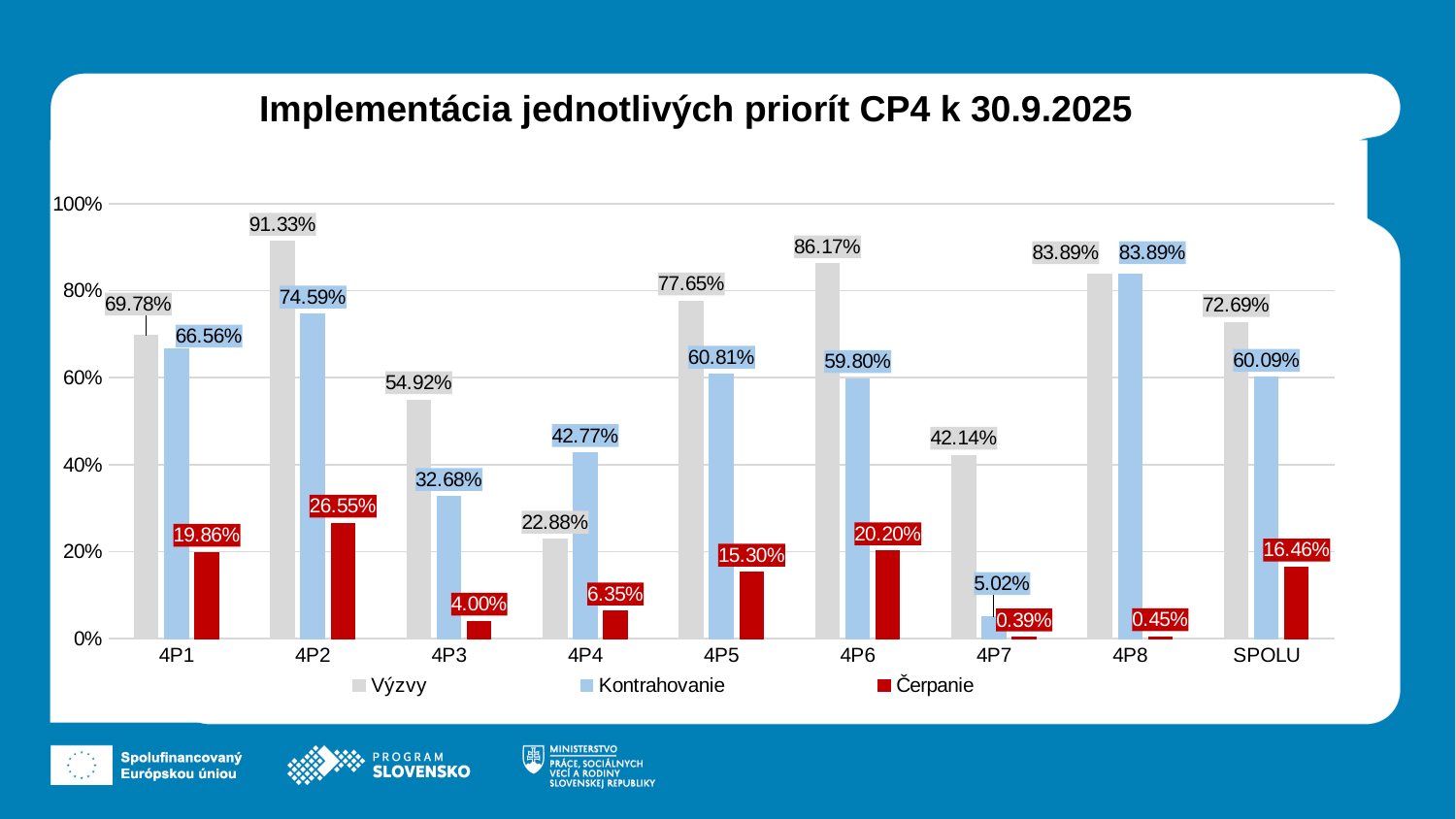
Is the Kontrahovanie value for 4P7 greater or less than 20%? less How many categories are shown on the x axis? 9 What is the Výzvy value for 4P2? 91.33% Which category has the lowest Čerpanie value? 4P7 How many series does the legend list? 3 Which is larger for 4P4: the Výzvy value or the Kontrahovanie value? Kontrahovanie What is the difference between the Výzvy and Kontrahovanie values for 4P2? 16.74% What is the Kontrahovanie value for SPOLU? 60.09% What is the title of the chart? Implementácia jednotlivých priorít CP4 k 30.9.2025 What kind of chart is shown on the slide? bar chart Which category has the highest Výzvy value? 4P2 What is the Čerpanie value for 4P6? 20.20%